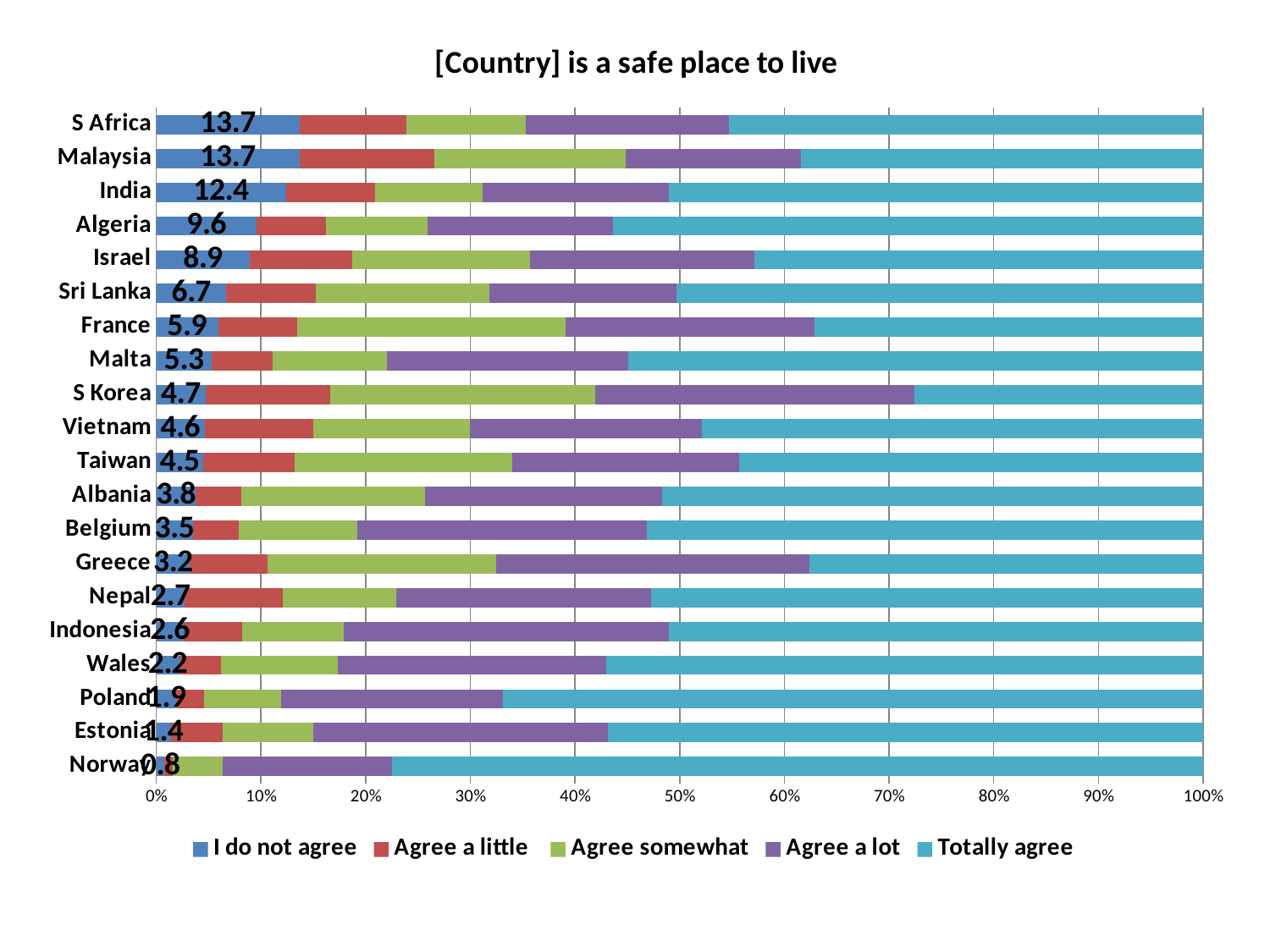
Is the 'Totally agree' share for Norway greater or less than 70%? greater How many countries are shown in the chart? 20 What is the 'I do not agree' value for Greece? 3.2 What is the 'I do not agree' value for S Africa? 13.7 What is the difference between the 'I do not agree' values for India and Algeria? 2.8 What type of chart is shown on the slide? Stacked bar chart Which has the larger 'I do not agree' value, Israel or Sri Lanka? Israel Which country has the lowest 'I do not agree' value? Norway Is the 'Totally agree' share for S Korea greater or less than 40%? less How many series does the legend list? 5 What is the 'I do not agree' value for Algeria? 9.6 What is the difference between the 'I do not agree' values for S Africa and Norway? 12.9